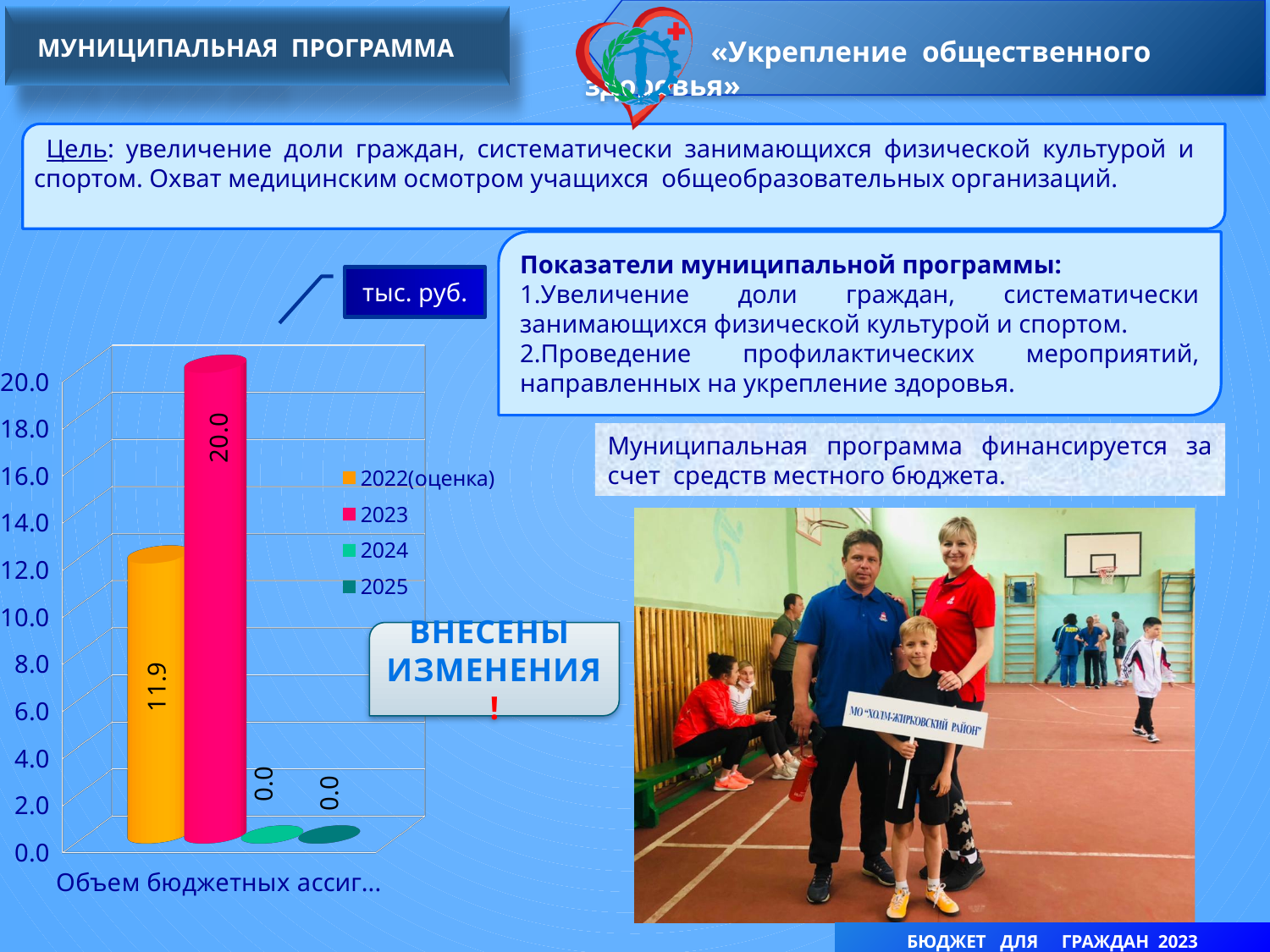
What kind of chart is shown on the slide? bar chart What is the value for 2022(оценка) on the chart? 11.9 Is the value for 2022(оценка) greater or less than 10.0? greater What is the value for 2025 on the chart? 0.0 What unit of measurement is shown in the box above the chart? тыс. руб. Which series has the highest value on the chart? 2023 What is the difference between the 2023 value and the 2022(оценка) value? 8.1 How many series does the chart legend list? 4 What colour is the bar for 2023 in the chart? pink What is the value for 2023 on the chart? 20.0 Which is larger, the value for 2022(оценка) or the value for 2023? 2023 What is the value for 2024 on the chart? 0.0